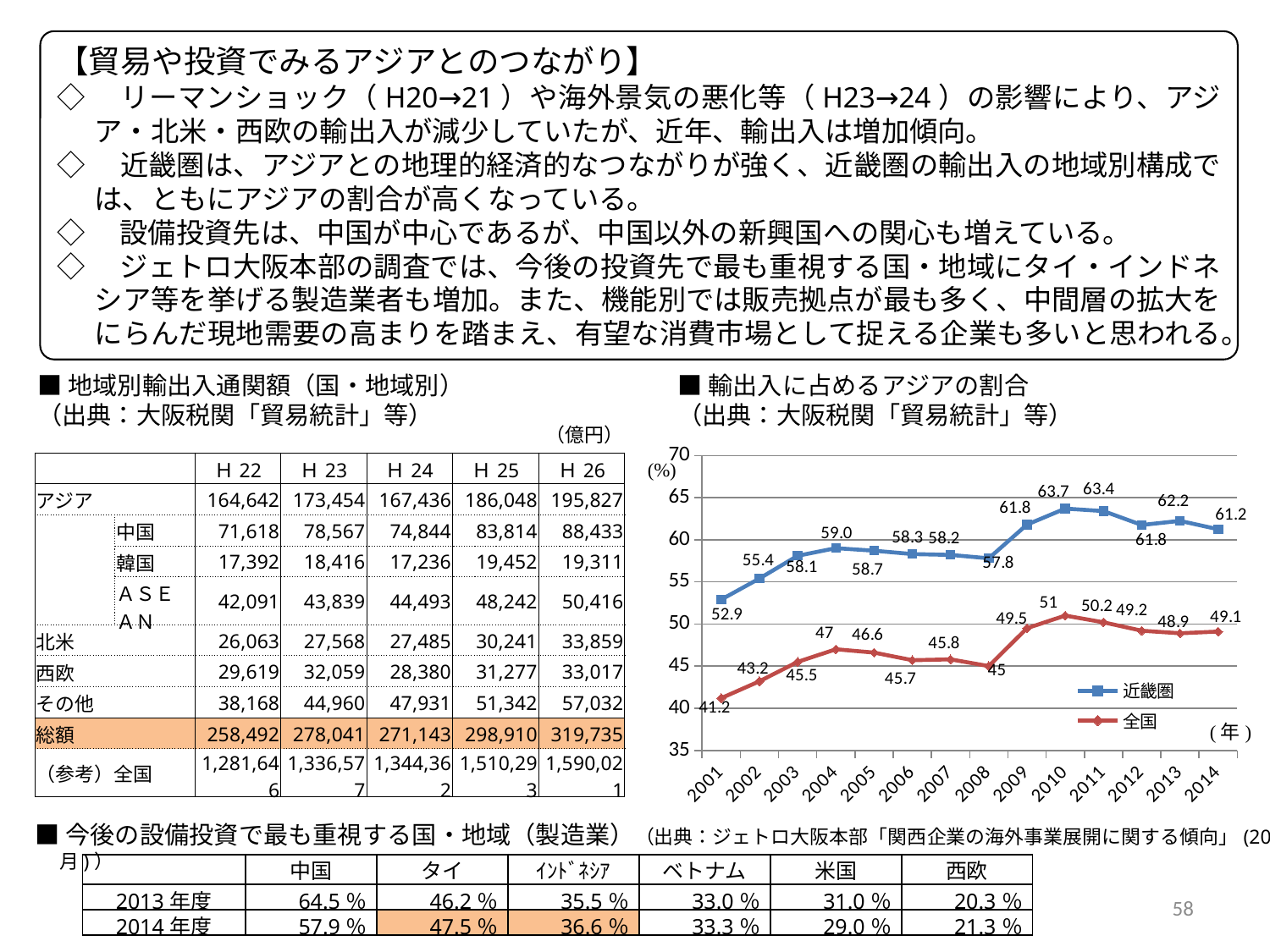
In the 輸出入に占めるアジアの割合 chart, which year has the lowest value for 全国? 2001 How many series does the legend of the 輸出入に占めるアジアの割合 chart list? 2 How many years are plotted on the x axis of the 輸出入に占めるアジアの割合 chart? 14 In the 輸出入に占めるアジアの割合 chart, what is the difference between 近畿圏 and 全国 in 2014? 12.1 In the 輸出入に占めるアジアの割合 chart, what is the value for 全国 in 2001? 41.2 In the 輸出入に占めるアジアの割合 chart, is the value for 全国 in 2010 greater or less than 50? greater In the 輸出入に占めるアジアの割合 chart, does the 近畿圏 series rise or fall from 2001 to 2004? rise In the 輸出入に占めるアジアの割合 chart, which year has the highest value for 近畿圏? 2010 In the 輸出入に占めるアジアの割合 chart, what is the value for 全国 in 2014? 49.1 In the 輸出入に占めるアジアの割合 chart, which series has the larger value in 2005, 近畿圏 or 全国? 近畿圏 What type of chart is shown under the heading 輸出入に占めるアジアの割合? line chart In the 輸出入に占めるアジアの割合 chart, what is the value for 近畿圏 in 2010? 63.7